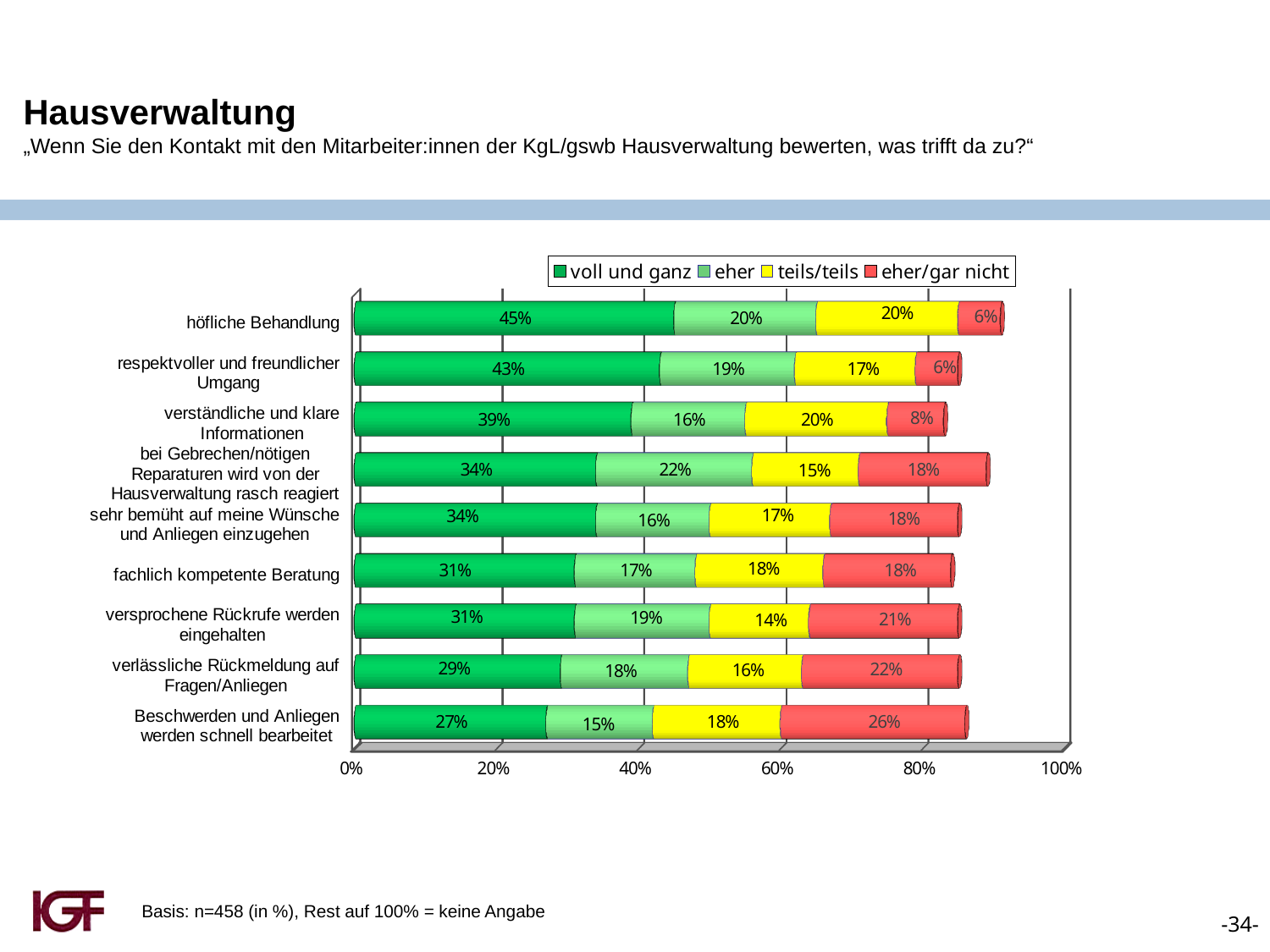
What is the "eher/gar nicht" value for "Beschwerden und Anliegen werden schnell bearbeitet"? 26% What kind of chart is shown on the slide? stacked bar chart Which is larger: the "eher" value for "bei Gebrechen/nötigen Reparaturen wird von der Hausverwaltung rasch reagiert" or for "sehr bemüht auf meine Wünsche und Anliegen einzugehen"? bei Gebrechen/nötigen Reparaturen wird von der Hausverwaltung rasch reagiert What is the "teils/teils" value for "versprochene Rückrufe werden eingehalten"? 14% How many series does the legend list? 4 Which category has the highest "voll und ganz" value? höfliche Behandlung What is the total of the stacked bar for "höfliche Behandlung"? 91% Which category has the lowest "voll und ganz" value? Beschwerden und Anliegen werden schnell bearbeitet Which category has the highest "eher/gar nicht" value? Beschwerden und Anliegen werden schnell bearbeitet What is the difference between the "voll und ganz" values for "höfliche Behandlung" and "verlässliche Rückmeldung auf Fragen/Anliegen"? 16% How many categories are shown on the chart? 9 What percentage of respondents answered "voll und ganz" for "höfliche Behandlung"? 45%